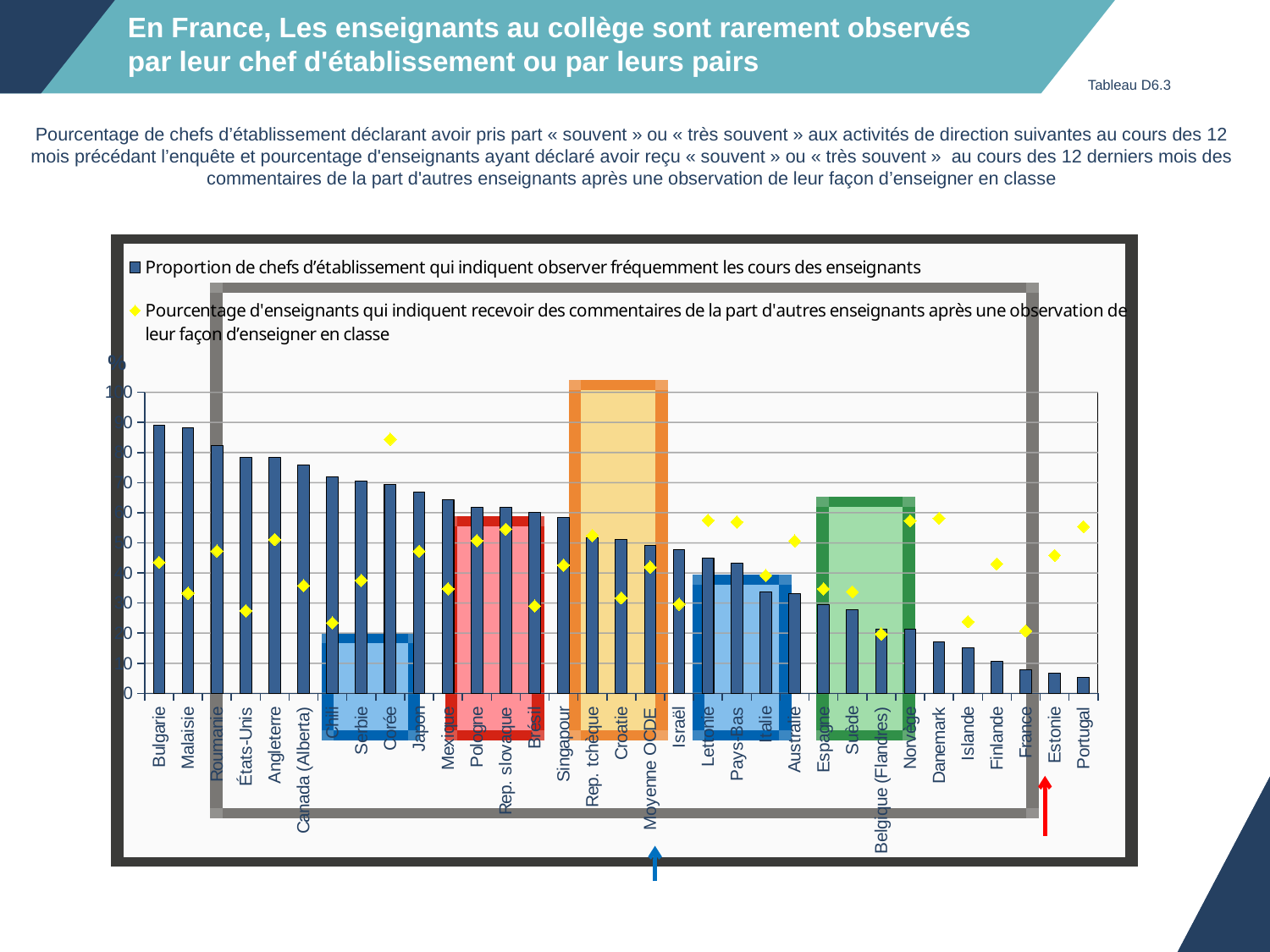
Is the bar value for Bulgarie greater or less than 50? greater Which category has the highest value for the diamond series (percentage of teachers receiving feedback from other teachers)? Corée How many series does the legend list? 2 Is the bar value for Portugal greater or less than 50? less Which has the larger bar value, Moyenne OCDE or Estonie? Moyenne OCDE Do the bar values generally rise or fall from left to right along the x axis? Fall What kind of chart is shown on the slide? Combination chart: bars with a second series drawn as diamond markers Which has the larger bar value, Bulgarie or France? Bulgarie How many countries/categories are shown along the x axis? 33 What table reference is given in the top right of the slide? Tableau D6.3 Is the bar value for France greater or less than 50? less